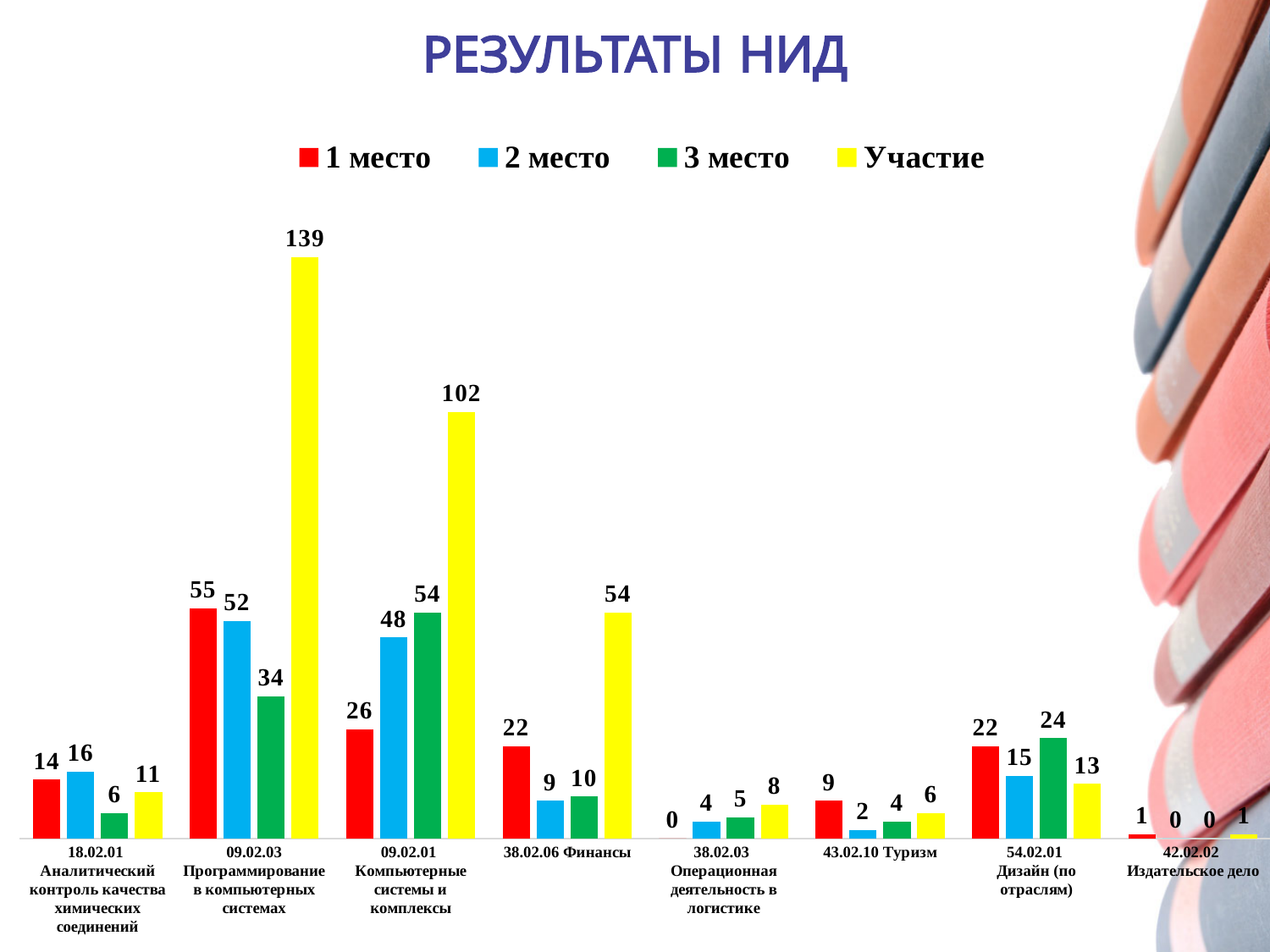
What is the total of all four series for 43.02.10 Туризм? 21 What is the value of 2 место for 09.02.01 Компьютерные системы и комплексы? 48 How many series does the legend list? 4 What is the value of 1 место for 38.02.06 Финансы? 22 How many categories (programs) are shown on the x axis? 8 What kind of chart is shown on the slide? bar chart What is the difference between the Участие values for 09.02.03 Программирование в компьютерных системах and 09.02.01 Компьютерные системы и комплексы? 37 What is the value of Участие for 09.02.03 Программирование в компьютерных системах? 139 Which category has the highest Участие value? 09.02.03 Программирование в компьютерных системах Which is larger for 54.02.01 Дизайн (по отраслям): 1 место or 3 место? 3 место What is the title of the chart? РЕЗУЛЬТАТЫ НИД Which category has the lowest 1 место value? 38.02.03 Операционная деятельность в логистике